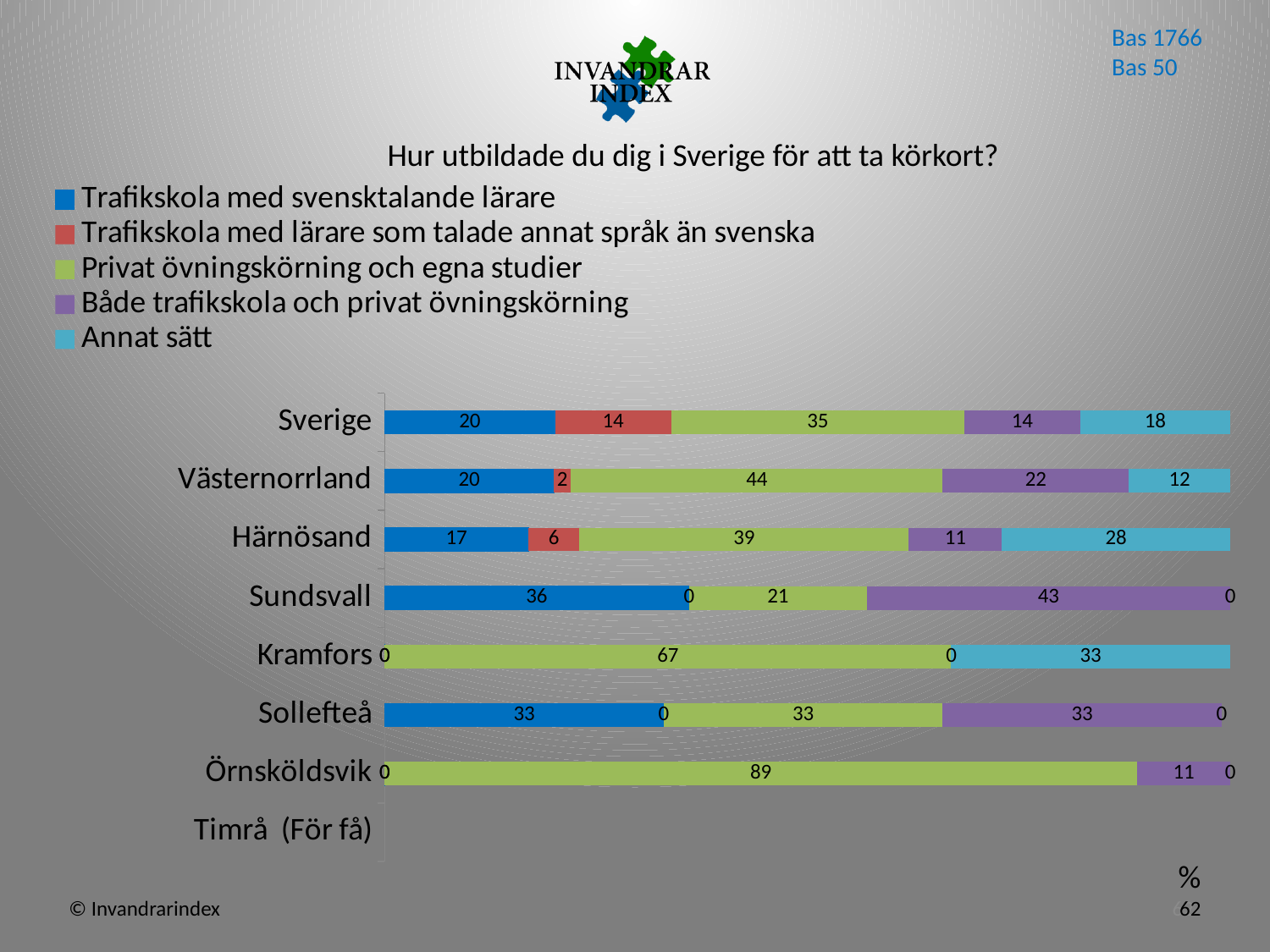
What is the value for 'Både trafikskola och privat övningskörning' for Sundsvall? 43 What is the title of the chart? Hur utbildade du dig i Sverige för att ta körkort? What is the value for 'Trafikskola med svensktalande lärare' for Sollefteå? 33 What is the value for 'Privat övningskörning och egna studier' for Sverige? 35 What is the value for 'Annat sätt' for Härnösand? 28 What is the value for 'Trafikskola med lärare som talade annat språk än svenska' for Västernorrland? 2 What is the difference between the 'Annat sätt' values for Härnösand and Västernorrland? 16 Which category has the highest value for 'Privat övningskörning och egna studier'? Örnsköldsvik Which category has the highest value for 'Trafikskola med svensktalande lärare'? Sundsvall Which is larger: the 'Både trafikskola och privat övningskörning' value for Västernorrland or for Härnösand? Västernorrland How many series does the legend list? 5 What type of chart is shown on the slide? stacked bar chart